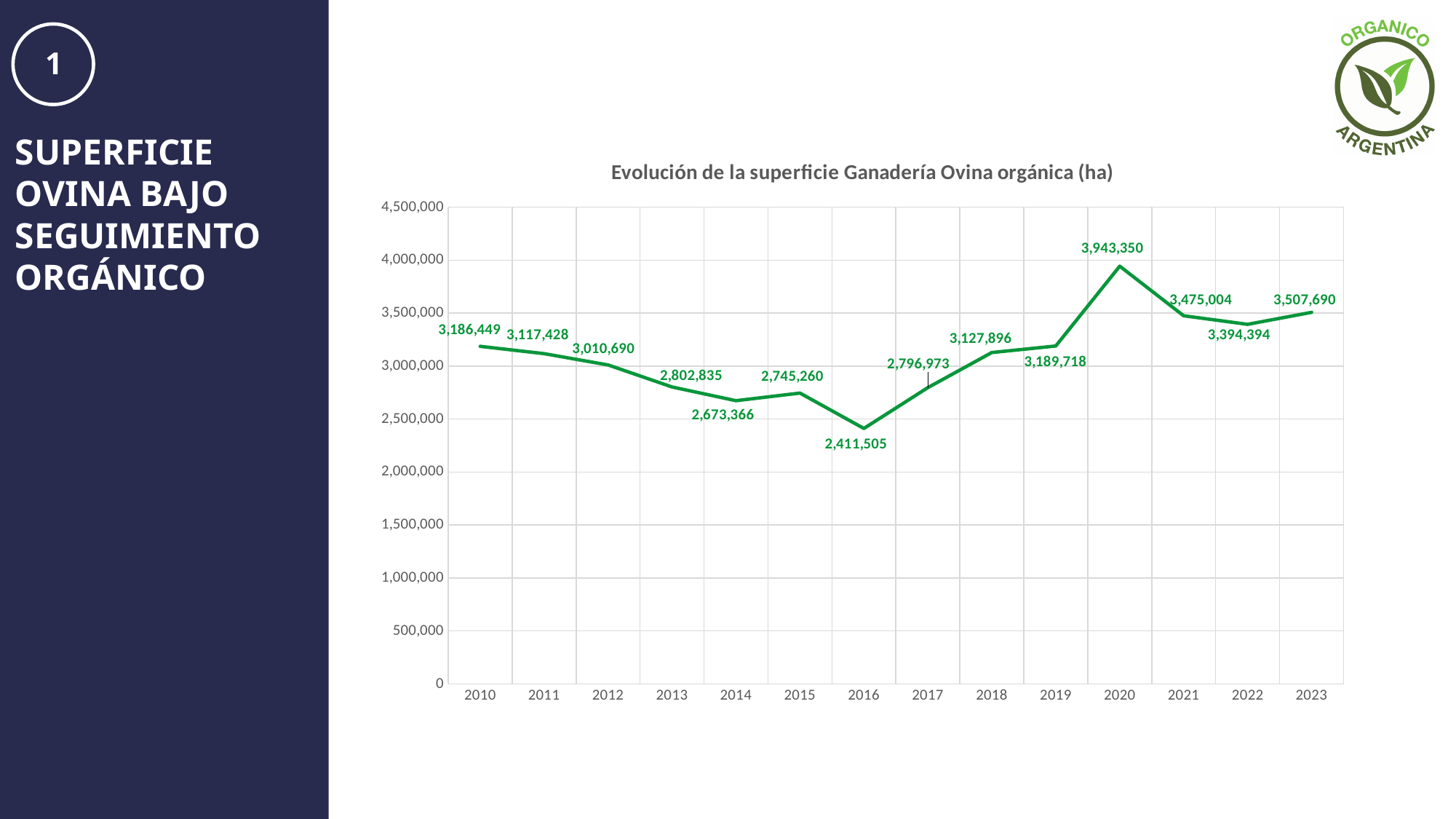
Is the value for 2014 greater or less than 3,000,000? less What is the difference between the values for 2023 and 2010? 321,241 Which year has the highest value in the chart? 2020 What kind of chart is shown on the slide? line chart What is the value for 2020 in the chart? 3,943,350 What is the difference between the values for 2020 and 2016? 1,531,845 Which year has the lowest value in the chart? 2016 Which is larger, the value for 2021 or the value for 2022? 2021 Do the values rise or fall from 2010 to 2014? fall How many years are plotted in the chart? 14 What is the value for 2023 in the chart? 3,507,690 What is the value for 2016 in the chart? 2,411,505